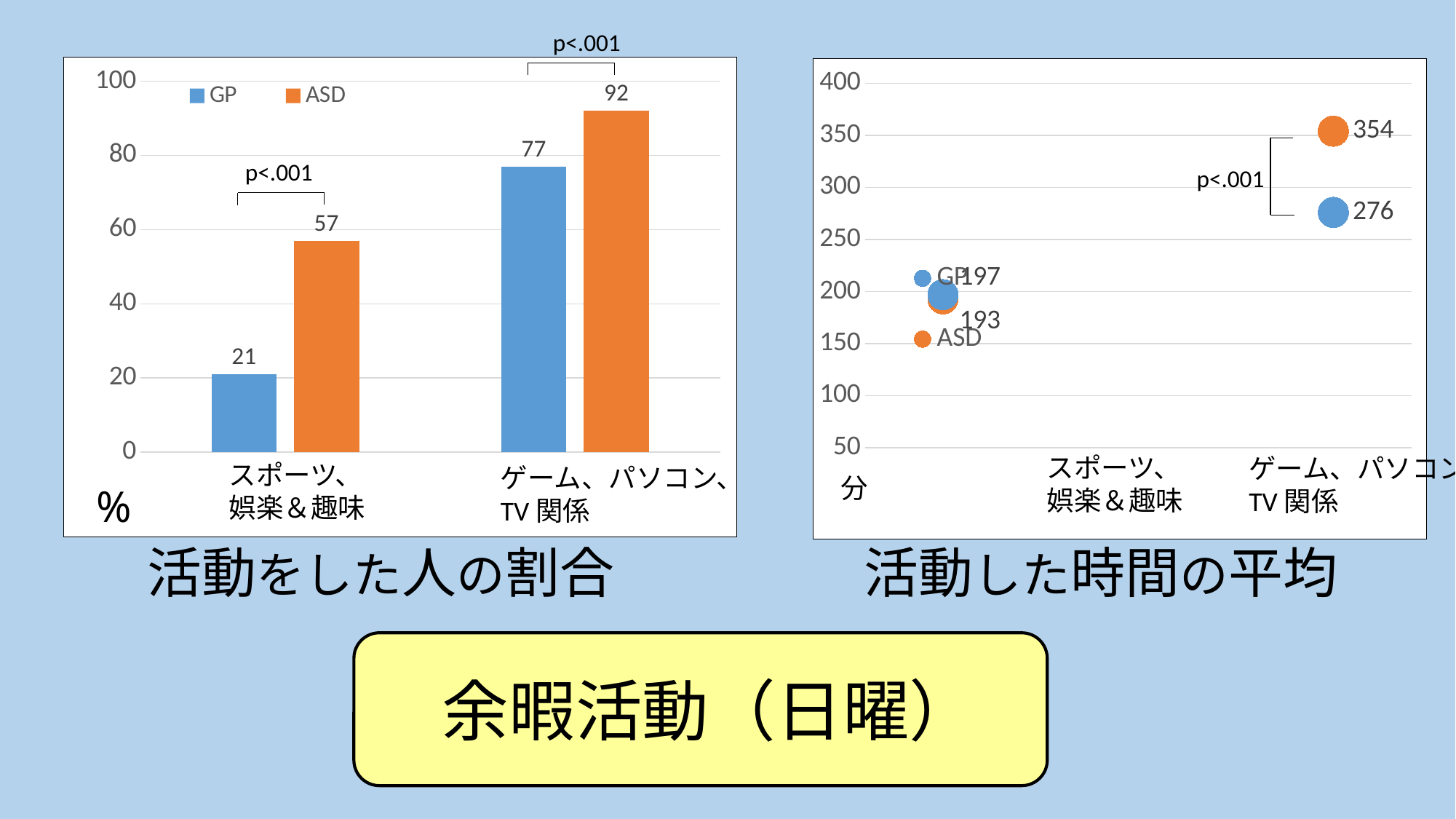
In the right chart (活動した時間の平均), what is the difference between ASD and GP in the ゲーム、パソコン、TV 関係 category? 78 In the left chart (活動をした人の割合), what is the value for GP in the ゲーム、パソコン、TV 関係 category? 77 In the left chart (活動をした人の割合), which bar is the lowest? GP, スポーツ、娯楽＆趣味 (21) In the right chart (活動した時間の平均), what is the value for GP in the スポーツ、娯楽＆趣味 category? 197 What kind of chart is the left chart (活動をした人の割合)? Bar chart In the left chart (活動をした人の割合), which bar is the highest? ASD, ゲーム、パソコン、TV 関係 (92) In the right chart (活動した時間の平均), what unit is shown on the vertical axis? 分 In the left chart (活動をした人の割合), what is the difference between ASD and GP in the スポーツ、娯楽＆趣味 category? 36 In the left chart (活動をした人の割合), what is the value for ASD in the スポーツ、娯楽＆趣味 category? 57 In the left chart (活動をした人の割合), how many series does the legend list? 2 In the right chart (活動した時間の平均), what is the value for ASD in the ゲーム、パソコン、TV 関係 category? 354 In the left chart (活動をした人の割合), which is larger in the ゲーム、パソコン、TV 関係 category, GP or ASD? ASD